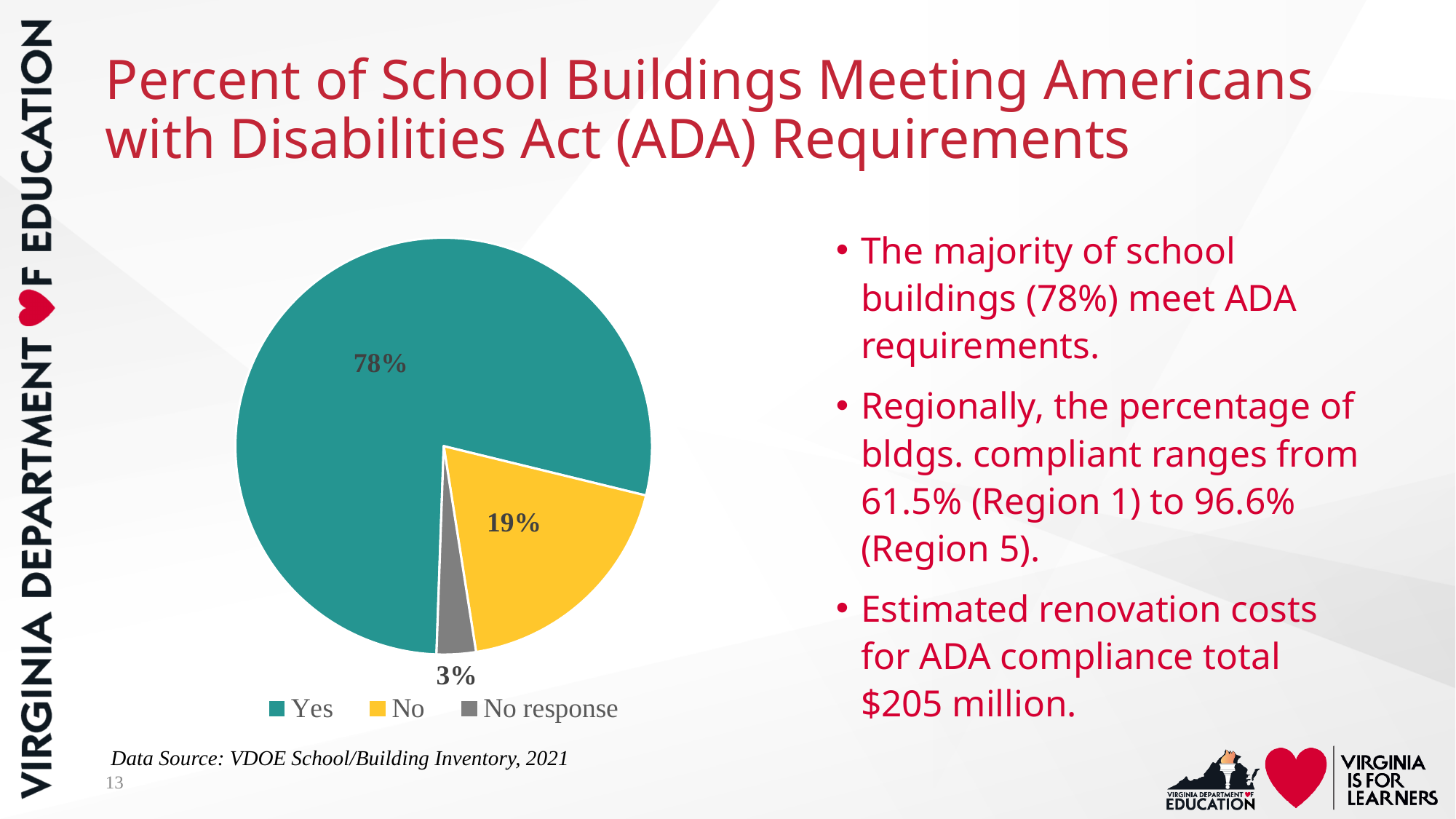
Which category has the smallest slice of the pie? No response Which category has the largest slice of the pie? Yes What percentage of school buildings are labeled "No"? 19% What data source is cited below the chart? VDOE School/Building Inventory, 2021 What colour is the "Yes" slice in the pie chart? Teal What percentage of school buildings are labeled "Yes" for meeting ADA requirements? 78% What type of chart is shown on the slide? Pie chart What share of the pie does the "No" slice represent? 19% What is the difference in percentage points between the "Yes" and "No" slices? 59 How many categories does the pie chart show? 3 Which is larger, the "No" slice or the "No response" slice? No What percentage is shown for "No response"? 3%